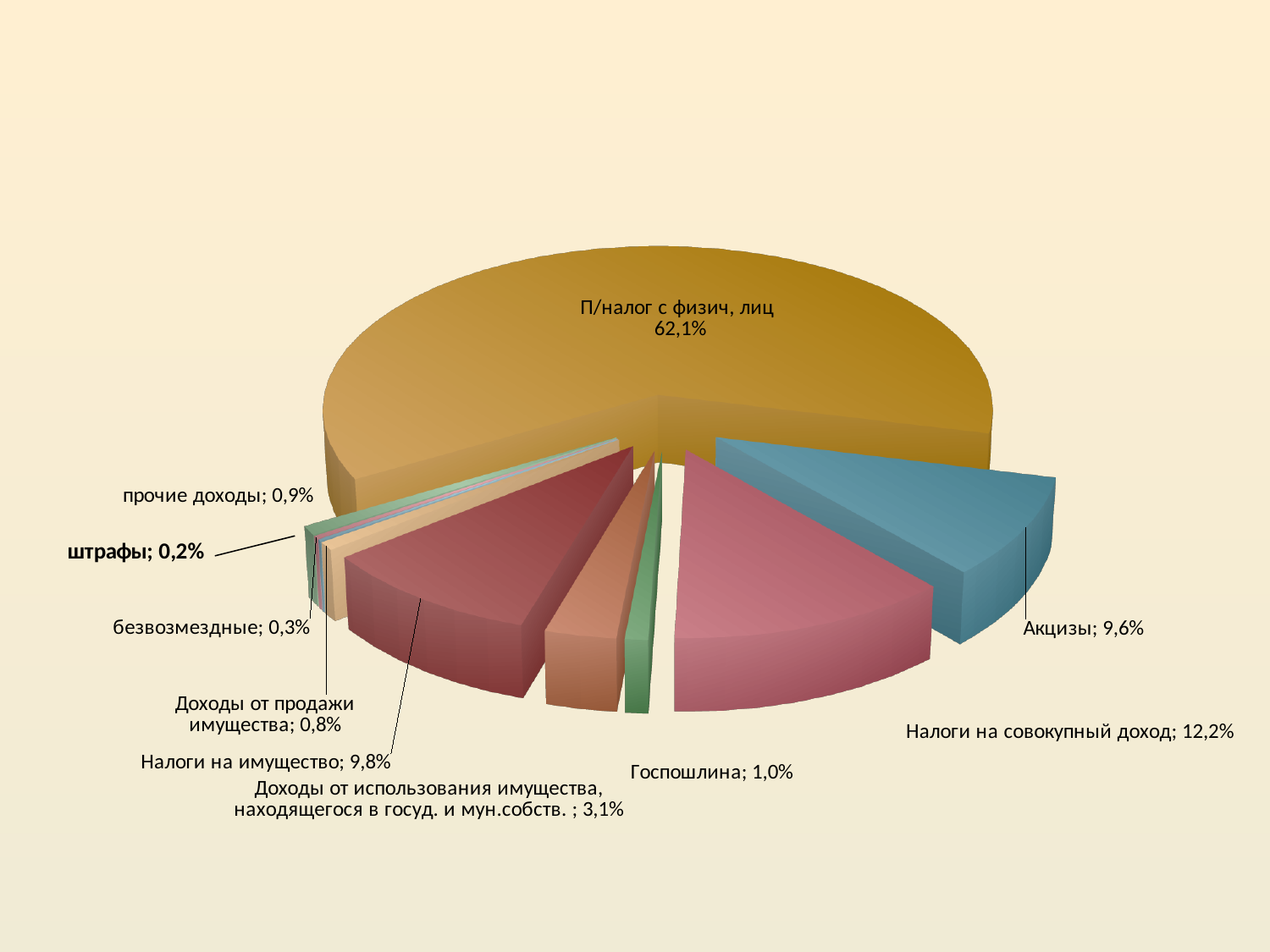
What is the value shown for "Налоги на совокупный доход"? 12,2% What is the value shown for "Акцизы"? 9,6% Which category has the smallest slice of the pie? штрафы What is the value shown for "Госпошлина"? 1,0% Which category has the largest slice of the pie? П/налог с физич, лиц What is the value shown for "штрафы"? 0,2% What is the difference between the values for "Налоги на совокупный доход" and "Акцизы"? 2,6% How many slices does the pie chart have? 10 What is the value shown for "Доходы от использования имущества, находящегося в госуд. и мун.собств."? 3,1% What share of the pie does "П/налог с физич, лиц" have? 62,1% What kind of chart is shown on the slide? pie chart Which is larger, "Налоги на имущество" or "Акцизы"? Налоги на имущество